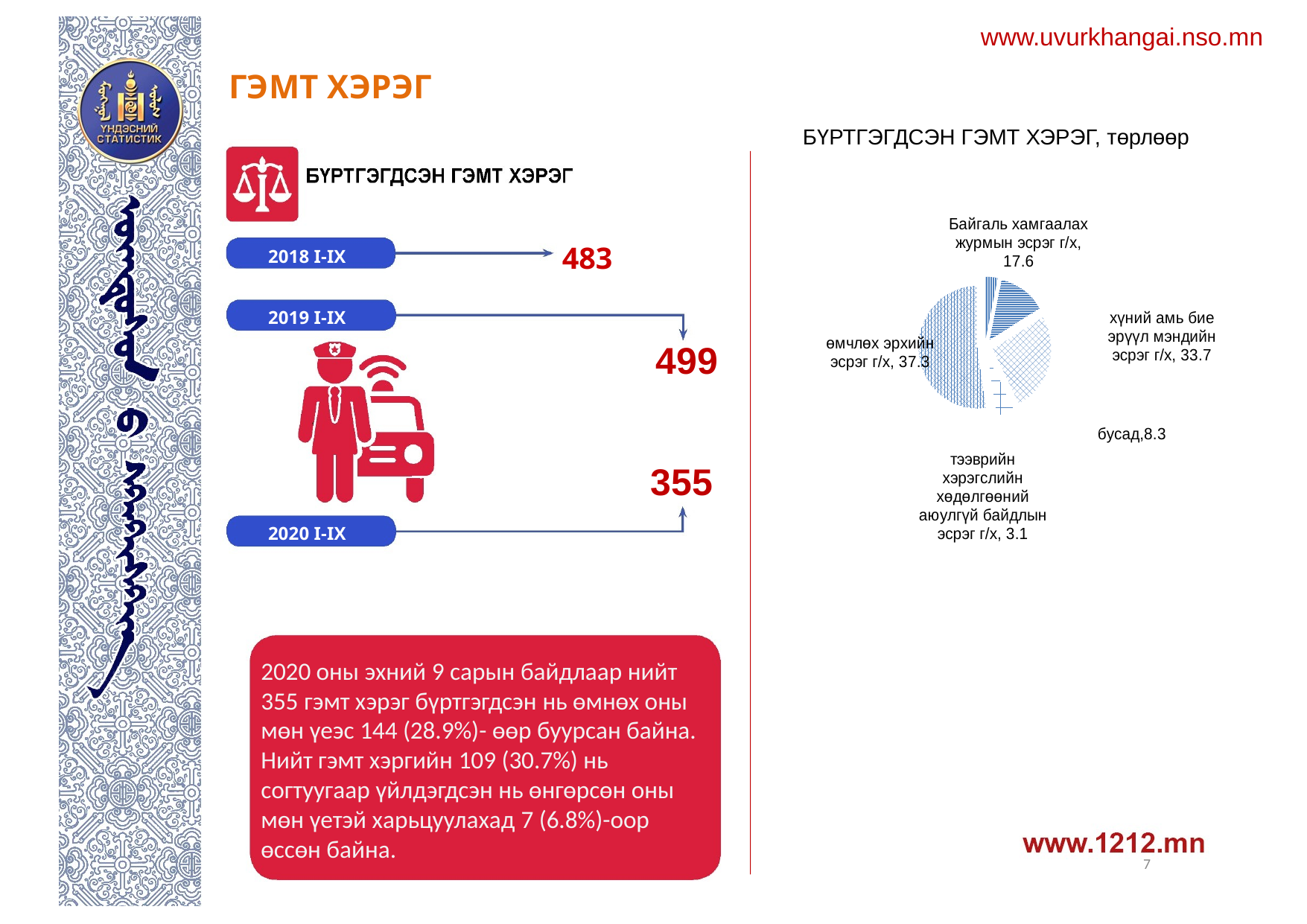
What kind of chart is the chart titled 'БҮРТГЭГДСЭН ГЭМТ ХЭРЭГ, төрлөөр'? Pie chart In the pie chart 'БҮРТГЭГДСЭН ГЭМТ ХЭРЭГ, төрлөөр', what is the difference between the values for 'өмчлөх эрхийн эсрэг г/х' and 'хүний амь бие эрүүл мэндийн эсрэг г/х'? 3.6 In the pie chart 'БҮРТГЭГДСЭН ГЭМТ ХЭРЭГ, төрлөөр', what share of the pie does 'өмчлөх эрхийн эсрэг г/х' take? 37.3 In the pie chart 'БҮРТГЭГДСЭН ГЭМТ ХЭРЭГ, төрлөөр', what is the value for 'Байгаль хамгаалах журмын эсрэг г/х'? 17.6 In the pie chart 'БҮРТГЭГДСЭН ГЭМТ ХЭРЭГ, төрлөөр', what is the value for 'бусад'? 8.3 In the pie chart 'БҮРТГЭГДСЭН ГЭМТ ХЭРЭГ, төрлөөр', which category has the largest slice? өмчлөх эрхийн эсрэг г/х How many slices does the pie chart 'БҮРТГЭГДСЭН ГЭМТ ХЭРЭГ, төрлөөр' have? 5 In the pie chart 'БҮРТГЭГДСЭН ГЭМТ ХЭРЭГ, төрлөөр', which is larger: 'Байгаль хамгаалах журмын эсрэг г/х' or 'бусад'? Байгаль хамгаалах журмын эсрэг г/х In the infographic on the left titled 'БҮРТГЭГДСЭН ГЭМТ ХЭРЭГ', what is the value for '2019 I-IX'? 499 In the infographic on the left titled 'БҮРТГЭГДСЭН ГЭМТ ХЭРЭГ', what is the difference between the values for '2019 I-IX' and '2020 I-IX'? 144 In the pie chart 'БҮРТГЭГДСЭН ГЭМТ ХЭРЭГ, төрлөөр', what is the value for 'хүний амь бие эрүүл мэндийн эсрэг г/х'? 33.7